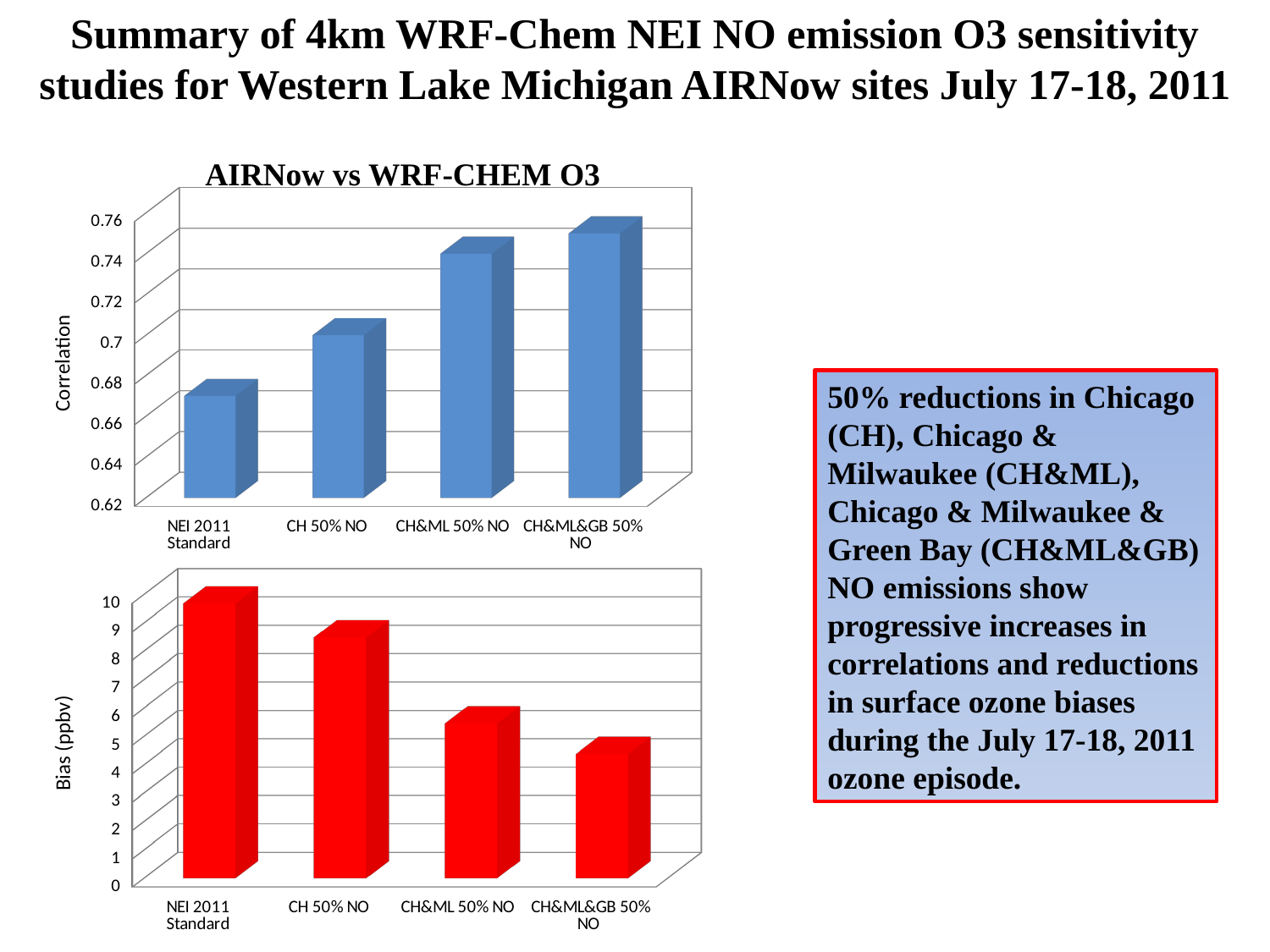
In the top chart 'AIRNow vs WRF-CHEM O3', which category has the highest correlation? CH&ML&GB 50% NO In the top chart 'AIRNow vs WRF-CHEM O3', do the correlation values rise or fall from left to right? rise In the bottom chart showing Bias (ppbv), which category has the highest bias? NEI 2011 Standard What is the y-axis label of the bottom chart? Bias (ppbv) In the bottom chart showing Bias (ppbv), which category has the lowest bias? CH&ML&GB 50% NO In the top chart 'AIRNow vs WRF-CHEM O3', which category has the lowest correlation? NEI 2011 Standard In the top chart 'AIRNow vs WRF-CHEM O3', is the correlation for CH&ML 50% NO greater or less than 0.72? greater In the top chart 'AIRNow vs WRF-CHEM O3', how many categories are plotted? 4 In the bottom chart showing Bias (ppbv), which is larger, the bias for CH 50% NO or for CH&ML 50% NO? CH 50% NO In the bottom chart showing Bias (ppbv), is the bias for CH&ML&GB 50% NO greater or less than 6? less In the top chart 'AIRNow vs WRF-CHEM O3', is the correlation for NEI 2011 Standard greater or less than 0.7? less What kind of chart is the top chart titled 'AIRNow vs WRF-CHEM O3'? bar chart